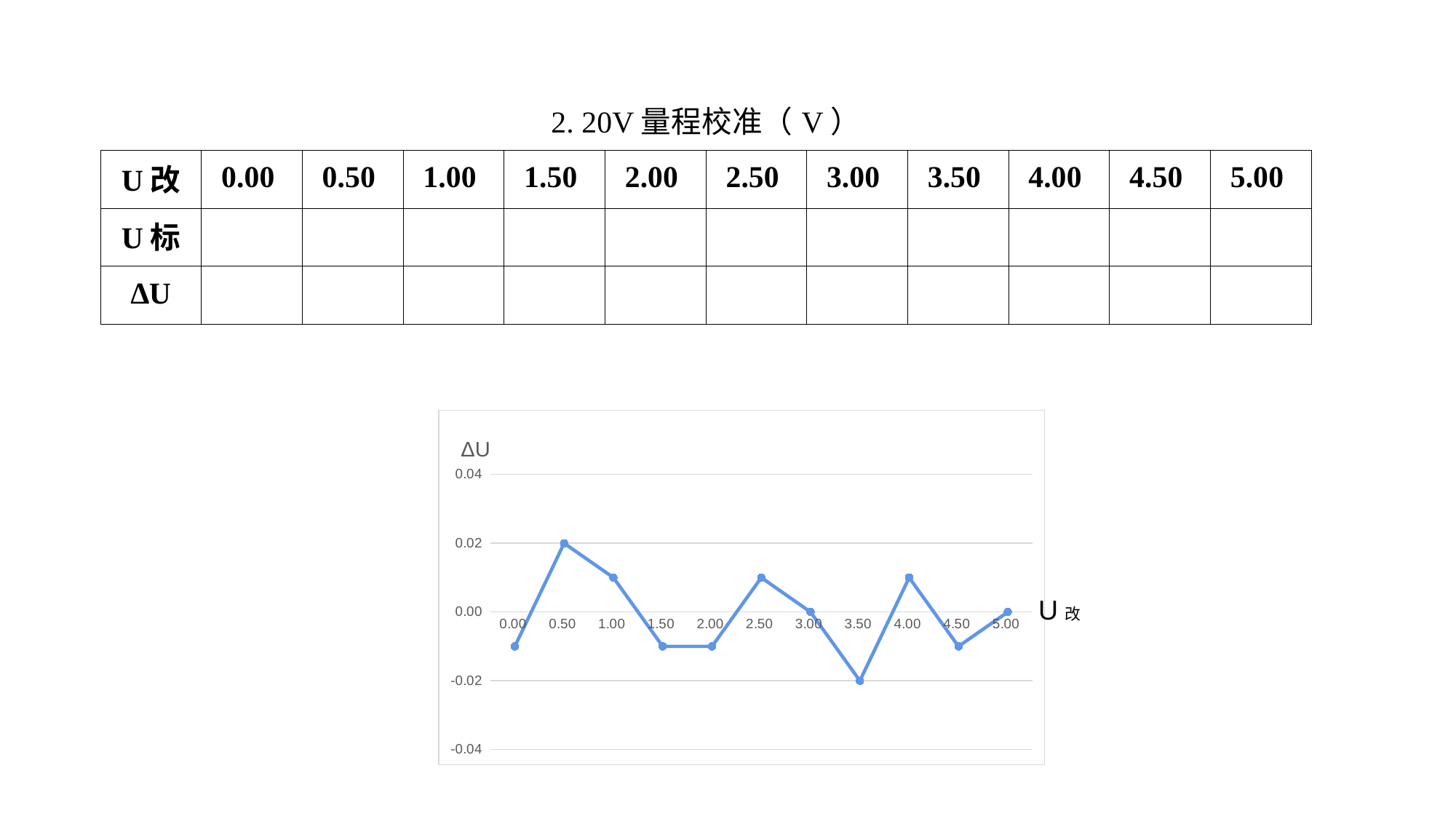
What is the label on the vertical axis of the chart? ΔU Is the value of ΔU at U改 = 4.00 greater or less than 0.00? greater What kind of chart is shown on the slide? line chart How many data points are plotted on the line chart? 11 Which has the larger ΔU: U改 = 0.50 or U改 = 1.00? 0.50 What is the value of ΔU at U改 = 3.00? 0.00 At which U改 value is ΔU highest? 0.50 What is the difference between ΔU at U改 = 0.50 and ΔU at U改 = 3.50? 0.04 Is the value of ΔU at U改 = 1.50 greater or less than 0.00? less What is the value of ΔU at U改 = 0.50? 0.02 At which U改 value is ΔU lowest? 3.50 What is the value of ΔU at U改 = 3.50? -0.02